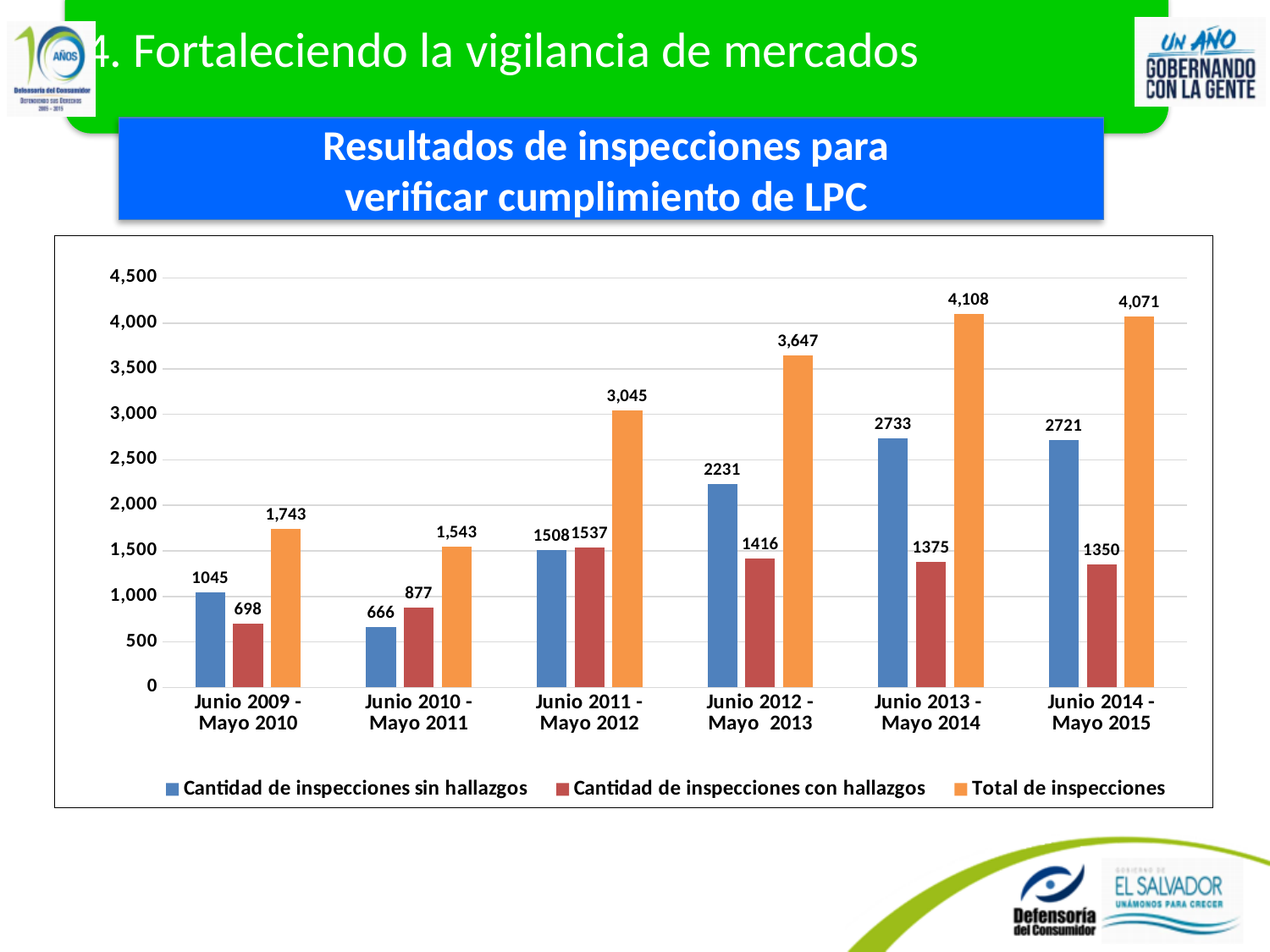
Does 'Total de inspecciones' rise or fall from Junio 2009 - Mayo 2010 to Junio 2013 - Mayo 2014? Rise What is the value of 'Total de inspecciones' for Junio 2013 - Mayo 2014? 4,108 Which period has the highest value for 'Total de inspecciones'? Junio 2013 - Mayo 2014 Which is larger for Junio 2009 - Mayo 2010: 'Cantidad de inspecciones sin hallazgos' or 'Cantidad de inspecciones con hallazgos'? Cantidad de inspecciones sin hallazgos What is the difference between 'Total de inspecciones' for Junio 2013 - Mayo 2014 and Junio 2014 - Mayo 2015? 37 Which period has the lowest value for 'Cantidad de inspecciones sin hallazgos'? Junio 2010 - Mayo 2011 What is the value of 'Cantidad de inspecciones sin hallazgos' for Junio 2010 - Mayo 2011? 666 What kind of chart is shown on the slide? Bar chart How many series does the legend list? 3 Is the value of 'Total de inspecciones' for Junio 2011 - Mayo 2012 greater or less than 3,000? greater How many periods are shown on the x axis? 6 What is the value of 'Cantidad de inspecciones con hallazgos' for Junio 2012 - Mayo 2013? 1416